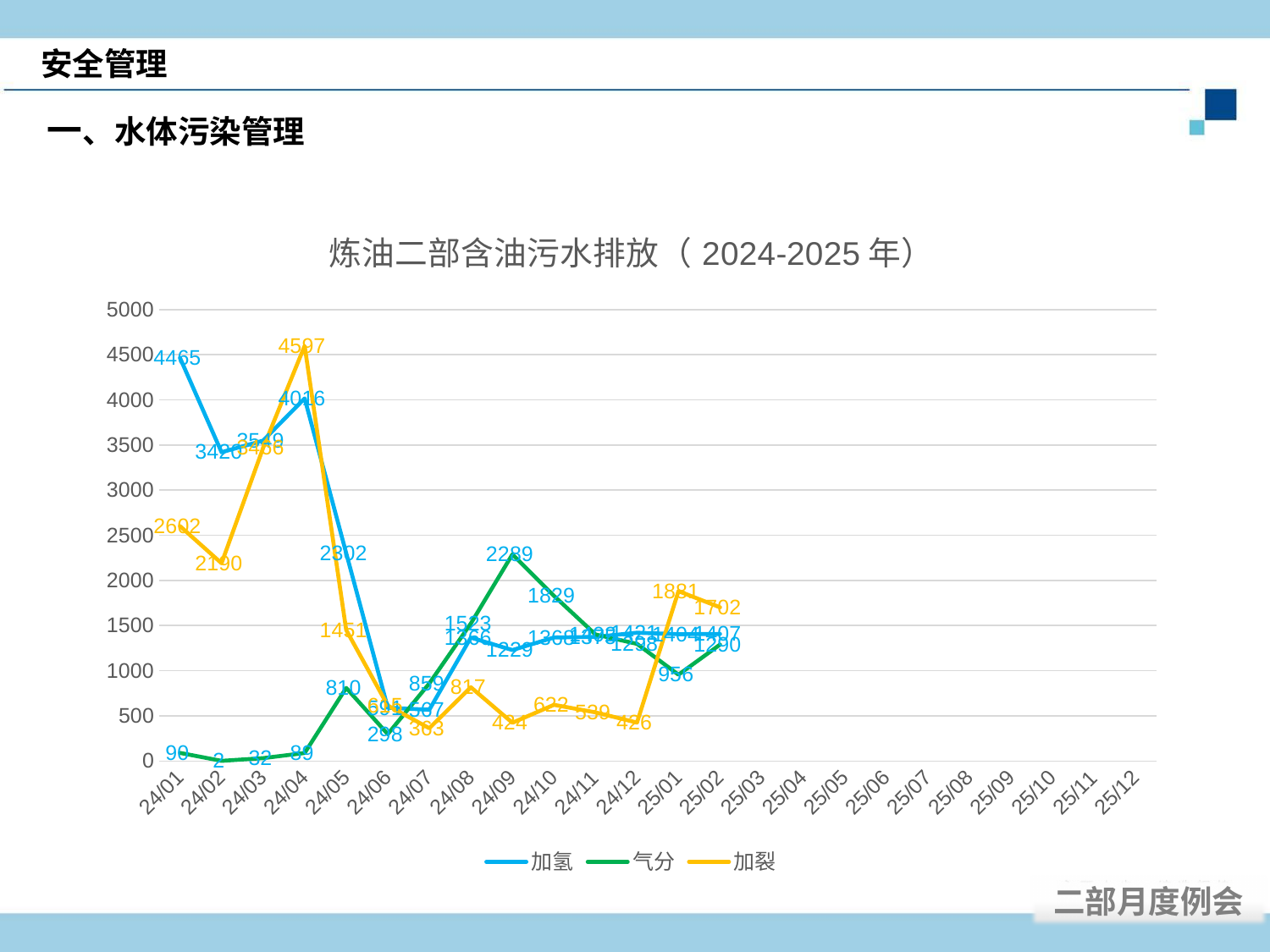
In which month does 气分 have its lowest value? 24/02 What is the value for 加裂 in 24/04? 4597 Which is larger in 24/04, the value for 加裂 or the value for 加氢? 加裂 In which month does 加裂 reach its highest value? 24/04 What type of chart is shown on the slide? line chart How many series does the legend list? 3 What is the value for 加氢 in 24/01? 4465 Is the value for 加氢 in 24/05 greater or less than 2000? greater What is the difference between the 加裂 values in 25/01 and 25/02? 179 What is the value for 气分 in 24/09? 2289 What is the value for 加裂 in 25/02? 1702 What is the title of the chart? 炼油二部含油污水排放（2024-2025年）